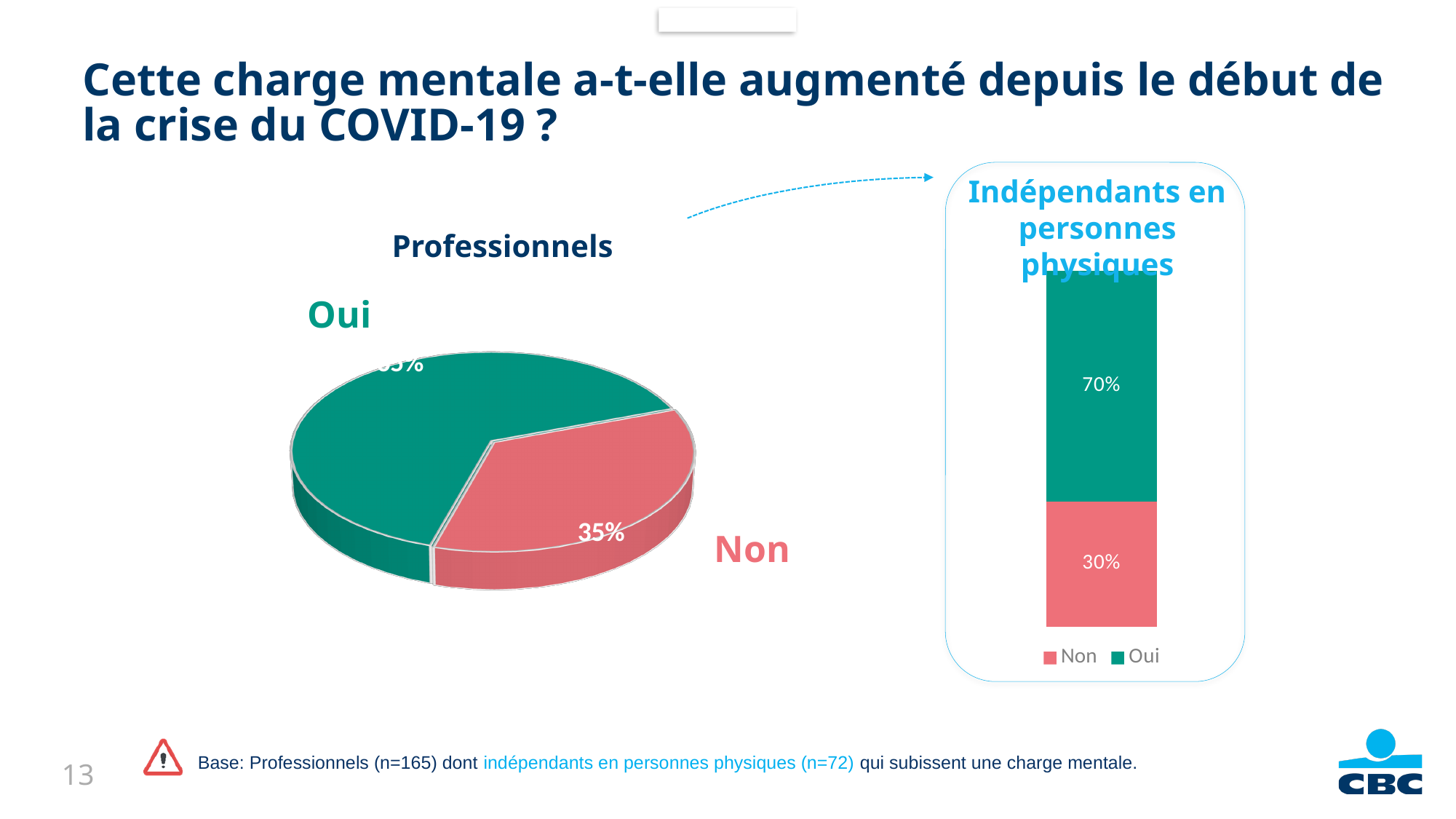
In the 'Indépendants en personnes physiques' chart, what is the difference between Oui and Non? 40% In the 'Indépendants en personnes physiques' chart, which segment is larger, Oui or Non? Oui In the 'Indépendants en personnes physiques' chart, what is the value for Oui? 70% How many series does the legend of the 'Indépendants en personnes physiques' chart list? 2 In the 'Indépendants en personnes physiques' chart, what is the value for Non? 30% What kind of chart is the 'Professionnels' chart? Pie chart In the 'Professionnels' pie chart, what is the value for Non? 35% In the 'Professionnels' pie chart, which slice is larger, Oui or Non? Oui What kind of chart is the 'Indépendants en personnes physiques' chart? Stacked bar chart In the 'Indépendants en personnes physiques' chart, what is the total of the stacked bar? 100% In the 'Indépendants en personnes physiques' chart, which colour represents Non? Red/pink How many slices does the 'Professionnels' pie chart have? 2